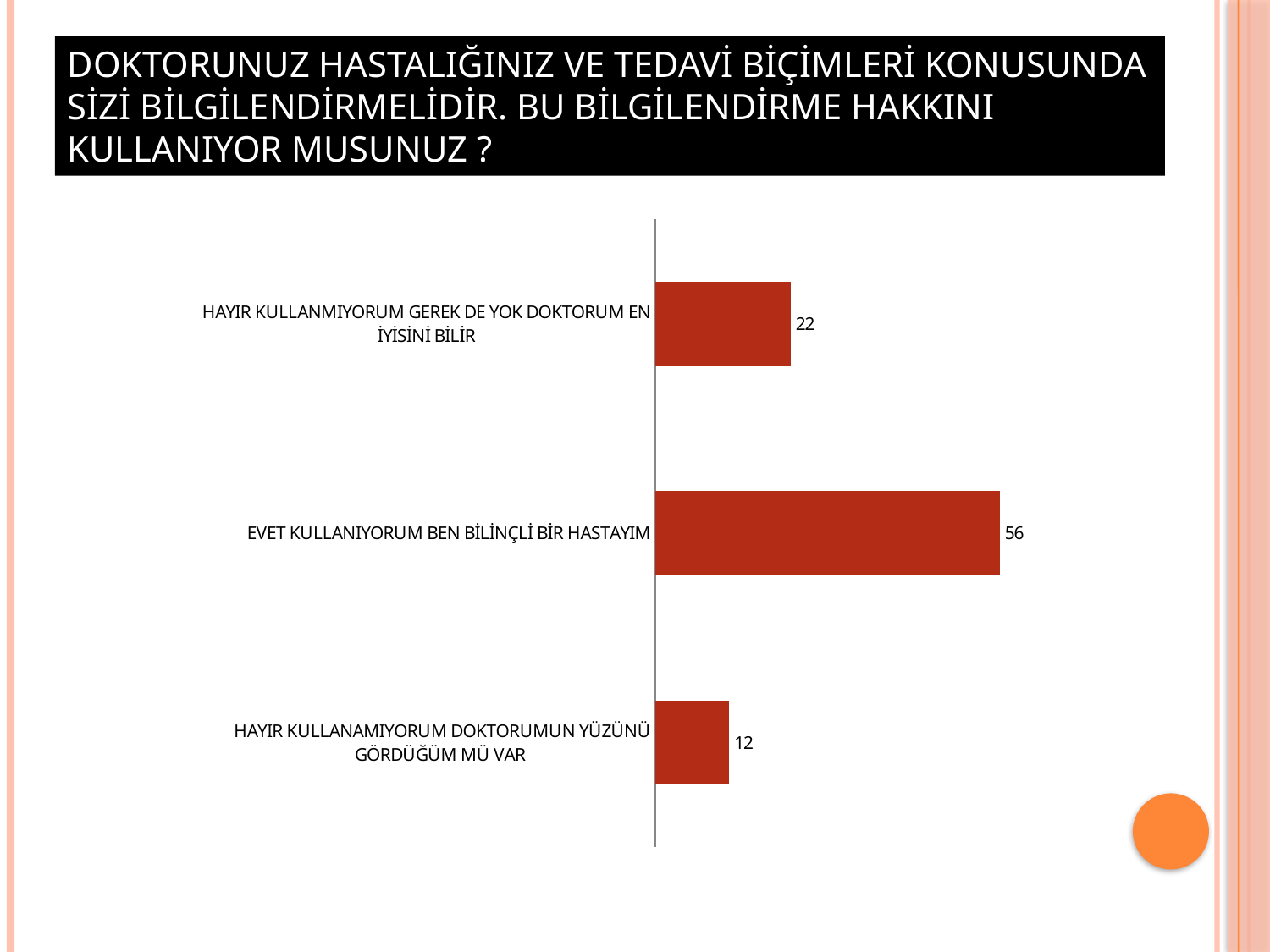
What kind of chart is shown on the slide? Bar chart How many categories are shown in the chart? 3 What is the difference between the values for "EVET KULLANIYORUM BEN BİLİNÇLİ BİR HASTAYIM" and "HAYIR KULLANMIYORUM GEREK DE YOK DOKTORUM EN İYİSİNİ BİLİR"? 34 What is the value for "EVET KULLANIYORUM BEN BİLİNÇLİ BİR HASTAYIM"? 56 Which is larger: the value for "HAYIR KULLANMIYORUM GEREK DE YOK DOKTORUM EN İYİSİNİ BİLİR" or the value for "HAYIR KULLANAMIYORUM DOKTORUMUN YÜZÜNÜ GÖRDÜĞÜM MÜ VAR"? HAYIR KULLANMIYORUM GEREK DE YOK DOKTORUM EN İYİSİNİ BİLİR Which category has the highest value? EVET KULLANIYORUM BEN BİLİNÇLİ BİR HASTAYIM What is the value for "HAYIR KULLANAMIYORUM DOKTORUMUN YÜZÜNÜ GÖRDÜĞÜM MÜ VAR"? 12 Which category has the lowest value? HAYIR KULLANAMIYORUM DOKTORUMUN YÜZÜNÜ GÖRDÜĞÜM MÜ VAR What colour are the bars in the chart? Red What is the difference between the values for "HAYIR KULLANMIYORUM GEREK DE YOK DOKTORUM EN İYİSİNİ BİLİR" and "HAYIR KULLANAMIYORUM DOKTORUMUN YÜZÜNÜ GÖRDÜĞÜM MÜ VAR"? 10 What is the value for "HAYIR KULLANMIYORUM GEREK DE YOK DOKTORUM EN İYİSİNİ BİLİR"? 22 What is the total of all three values shown in the chart? 90